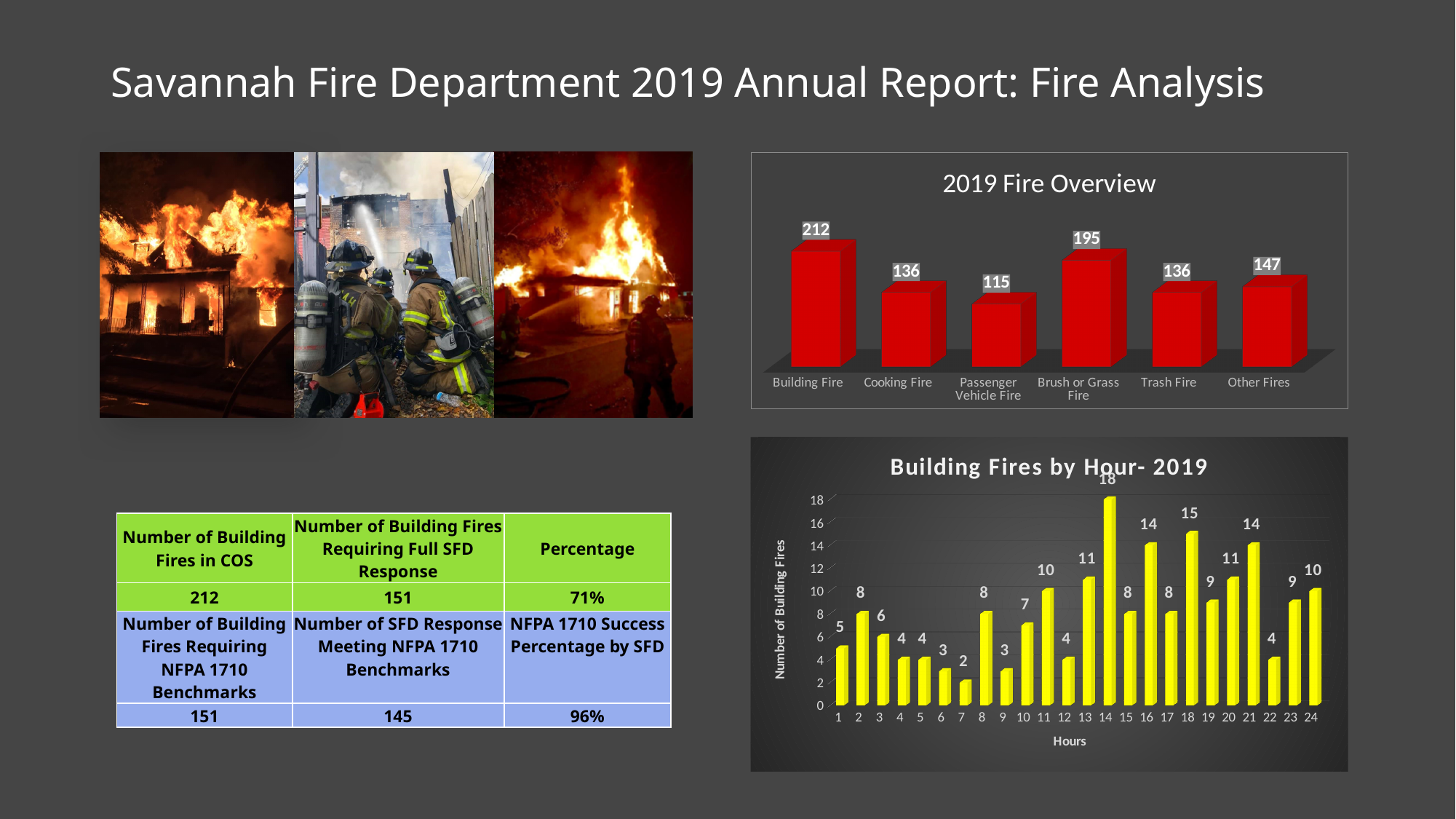
How many categories are shown in the 2019 Fire Overview chart? 6 In the 2019 Fire Overview chart, what is the value for Passenger Vehicle Fire? 115 In the 2019 Fire Overview chart, how many Building Fires were there? 212 In the 2019 Fire Overview chart, which is larger: Other Fires or Trash Fire? Other Fires In the Building Fires by Hour- 2019 chart, which hour has the lowest number of building fires? 7 What type of chart is the Building Fires by Hour- 2019 chart? Bar chart In the Building Fires by Hour- 2019 chart, how many building fires occurred at hour 14? 18 In the Building Fires by Hour- 2019 chart, what is the difference between hour 18 and hour 19? 6 In the Building Fires by Hour- 2019 chart, what is the value for hour 21? 14 What is the y-axis label of the Building Fires by Hour- 2019 chart? Number of Building Fires In the 2019 Fire Overview chart, which category has the lowest value? Passenger Vehicle Fire In the 2019 Fire Overview chart, what is the difference between Building Fire and Brush or Grass Fire? 17